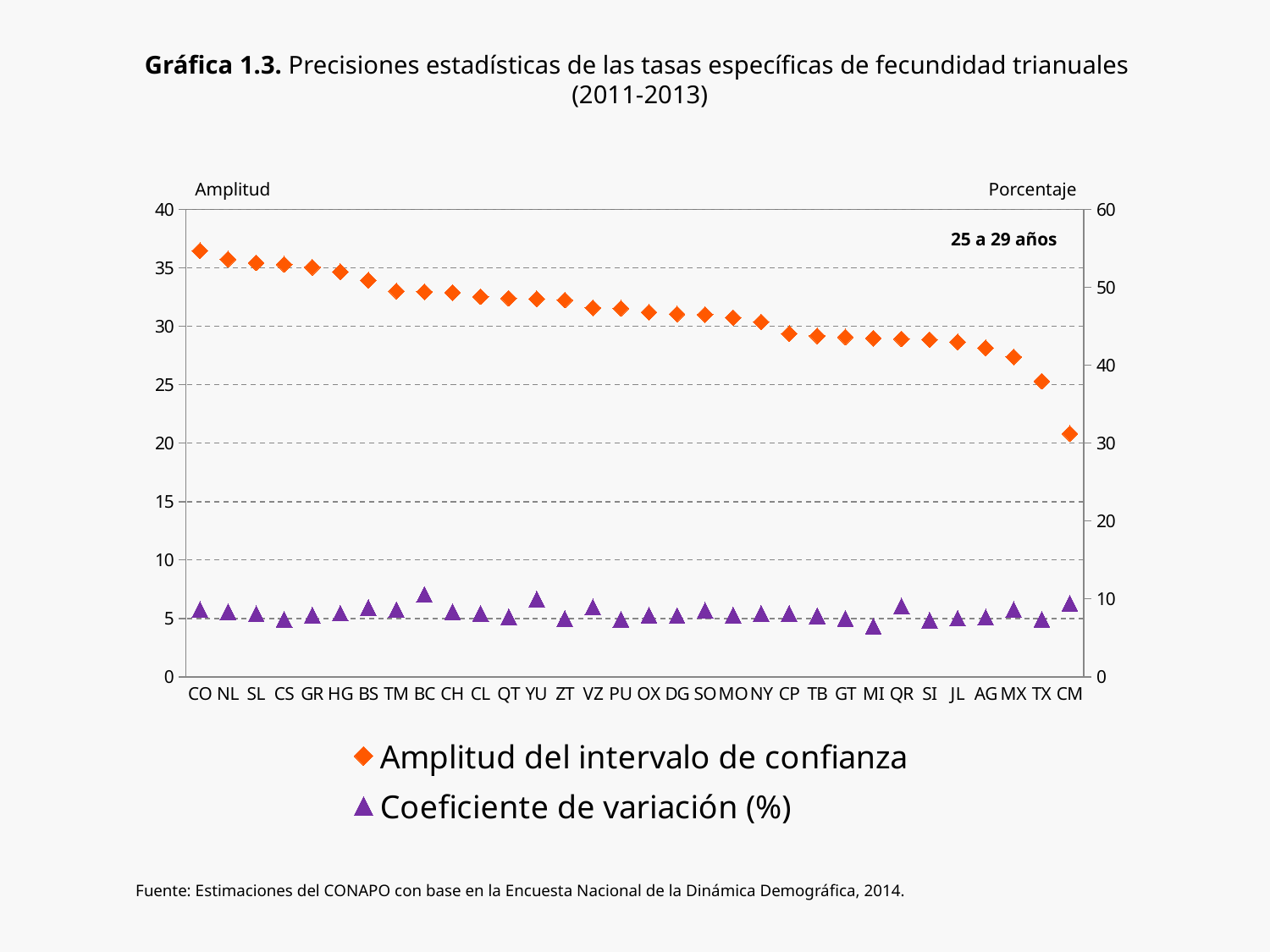
How many categories are shown on the x axis? 32 Is the Amplitud del intervalo de confianza value for TX greater or less than 30? less Which category has the lowest value for Coeficiente de variación (%)? MI Which category has the lowest value for Amplitud del intervalo de confianza? CM Is the Amplitud del intervalo de confianza value for CM greater or less than 25? less Do the Amplitud del intervalo de confianza values rise or fall from left to right along the x axis? fall What kind of chart is this? scatter chart What age group is indicated in the annotation inside the plot area? 25 a 29 años How many series does the legend list? 2 Is the Amplitud del intervalo de confianza value for CO greater or less than 35? greater Which is larger, the Amplitud del intervalo de confianza for NL or for TX? NL Which category has the highest value for Amplitud del intervalo de confianza? CO